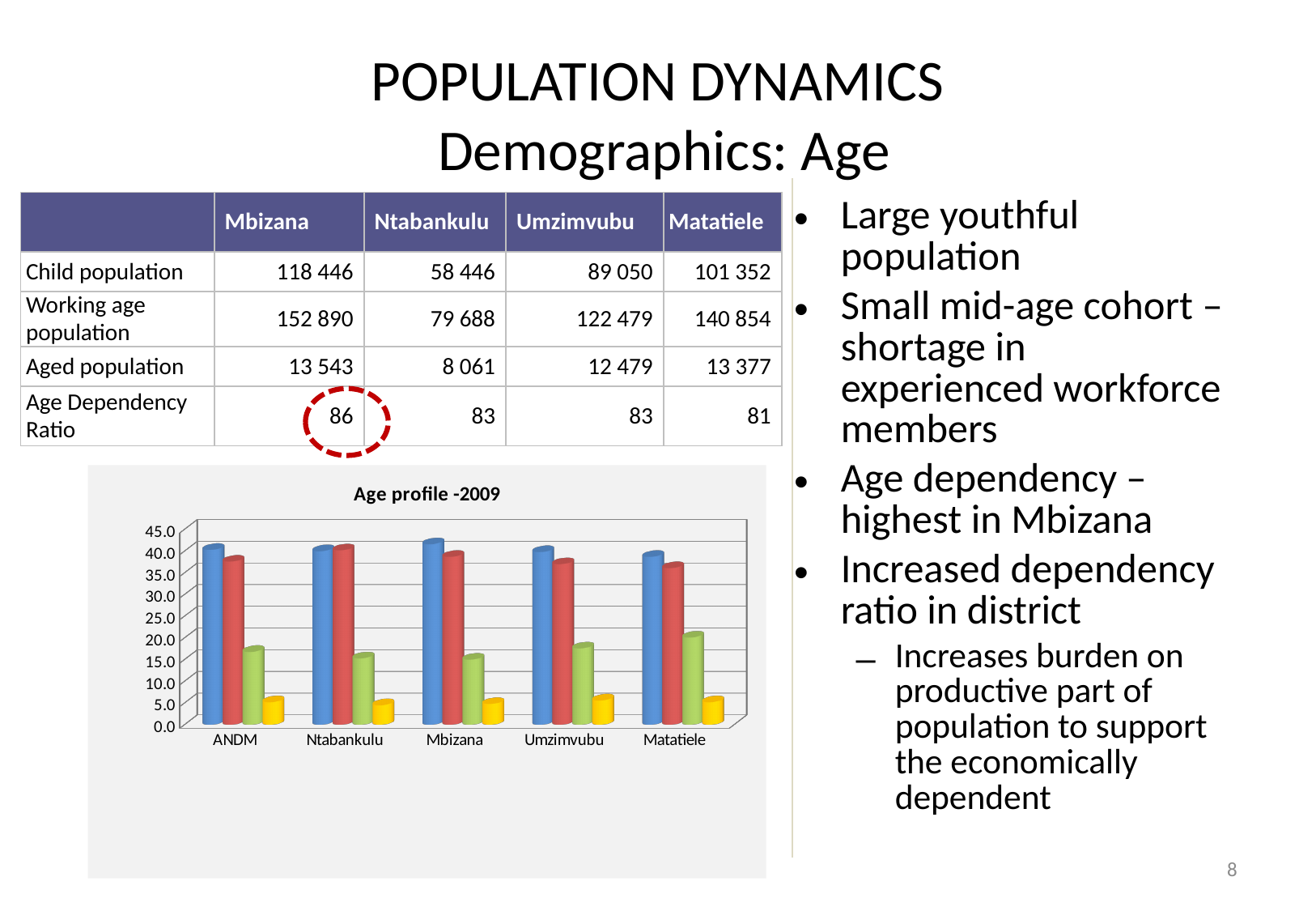
In the "Age profile -2009" chart, is the value of the yellow bar for Matatiele greater or less than 10.0? less What kind of chart is the "Age profile -2009" chart? bar chart In the "Age profile -2009" chart, which is larger for ANDM: the blue bar or the yellow bar? the blue bar How many bars are plotted for each category in the "Age profile -2009" chart? 4 What is the title of the chart on the slide? Age profile -2009 In the "Age profile -2009" chart, is the value of the green bar for ANDM greater or less than 10.0? greater In the "Age profile -2009" chart, which is larger for Matatiele: the red bar or the green bar? the red bar In the "Age profile -2009" chart, is the value of the blue bar for ANDM greater or less than 35.0? greater How many categories are shown on the x axis of the "Age profile -2009" chart? 5 What is the highest value labelled on the y axis of the "Age profile -2009" chart? 45.0